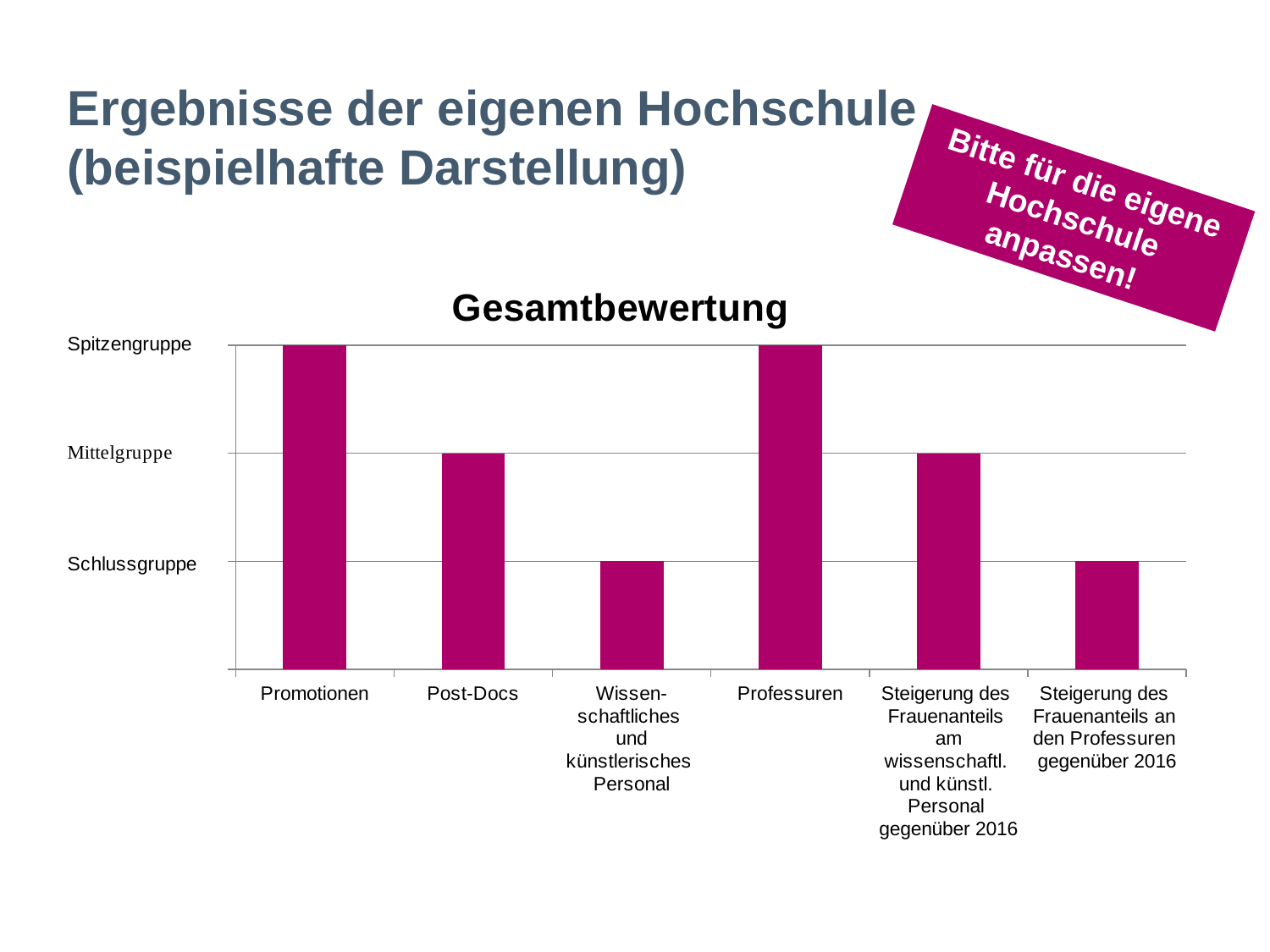
Which rating group does the bar for Steigerung des Frauenanteils an den Professuren gegenüber 2016 reach? Schlussgruppe Which rating group does the bar for Post-Docs reach? Mittelgruppe What kind of chart is shown on the slide? bar chart How many categories are shown on the x axis of the chart? 6 Which rating group does the bar for Steigerung des Frauenanteils am wissenschaftl. und künstl. Personal gegenüber 2016 reach? Mittelgruppe Which bar is taller, Promotionen or Post-Docs? Promotionen How many categories reach the Spitzengruppe level? 2 Which rating group does the bar for Wissenschaftliches und künstlerisches Personal reach? Schlussgruppe Which rating group does the bar for Promotionen reach? Spitzengruppe Which rating group does the bar for Professuren reach? Spitzengruppe Which bar is taller, Professuren or Steigerung des Frauenanteils an den Professuren gegenüber 2016? Professuren What is the title of the chart? Gesamtbewertung